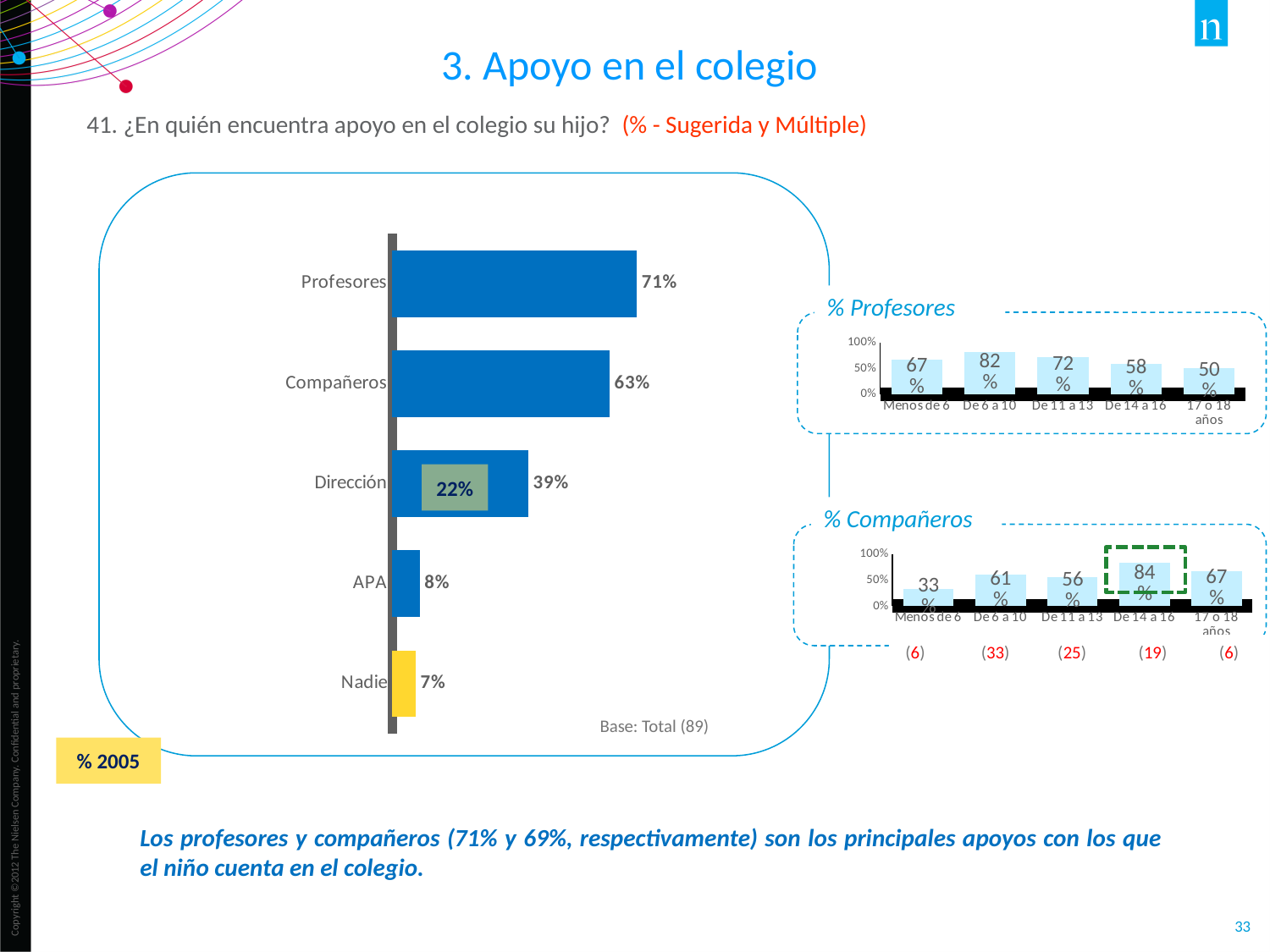
In the main bar chart, how many categories are shown? 5 In the '% Profesores' chart, which age group has the lowest value? 17 o 18 años In the main bar chart, what is the 2005 value shown for Dirección? 22% In the main bar chart, what is the value for Dirección? 39% In the '% Compañeros' chart, which is larger: De 6 a 10 or De 11 a 13? De 6 a 10 What kind of chart is the main chart on the left? Bar chart In the '% Compañeros' chart, which age group has the highest value? De 14 a 16 In the '% Compañeros' chart, what is the value for Menos de 6? 33% In the main bar chart, what is the difference between Profesores and Compañeros? 8% In the '% Profesores' chart, what is the value for De 6 a 10? 82% In the main bar chart, which category has the lowest value? Nadie In the main bar chart, what is the value for Profesores? 71%